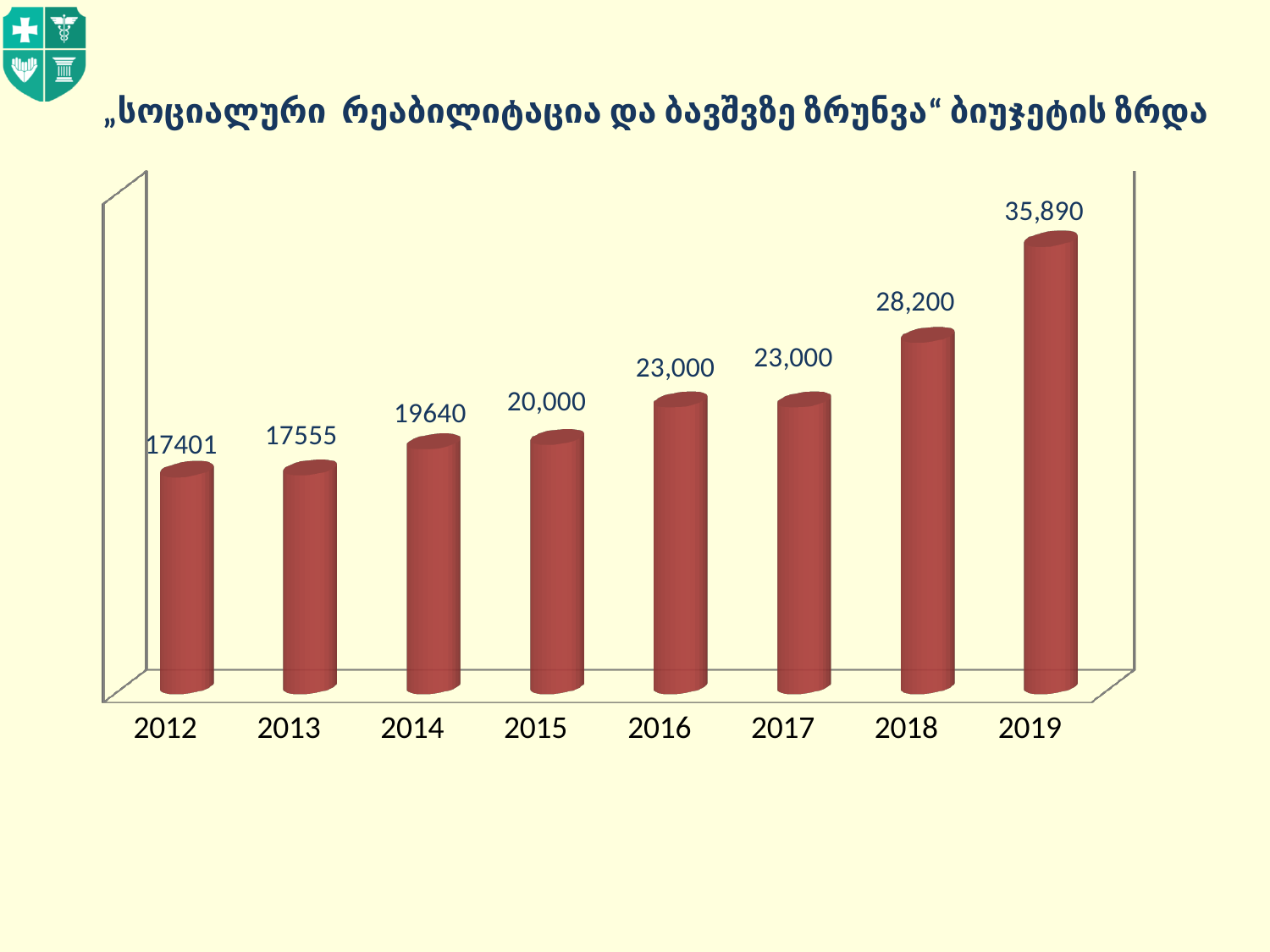
What kind of chart is shown on the slide? bar chart Which year has the highest value? 2019 Which is larger, the value for 2015 or the value for 2016? 2016 What is the value for 2014? 19640 What is the value for 2012? 17401 What is the difference between the values for 2013 and 2012? 154 Which year has the lowest value? 2012 How many years are shown on the x axis? 8 Do the values rise or fall from 2012 to 2019? rise What is the value for 2019? 35,890 What is the difference between the values for 2019 and 2018? 7,690 What is the value for 2018? 28,200